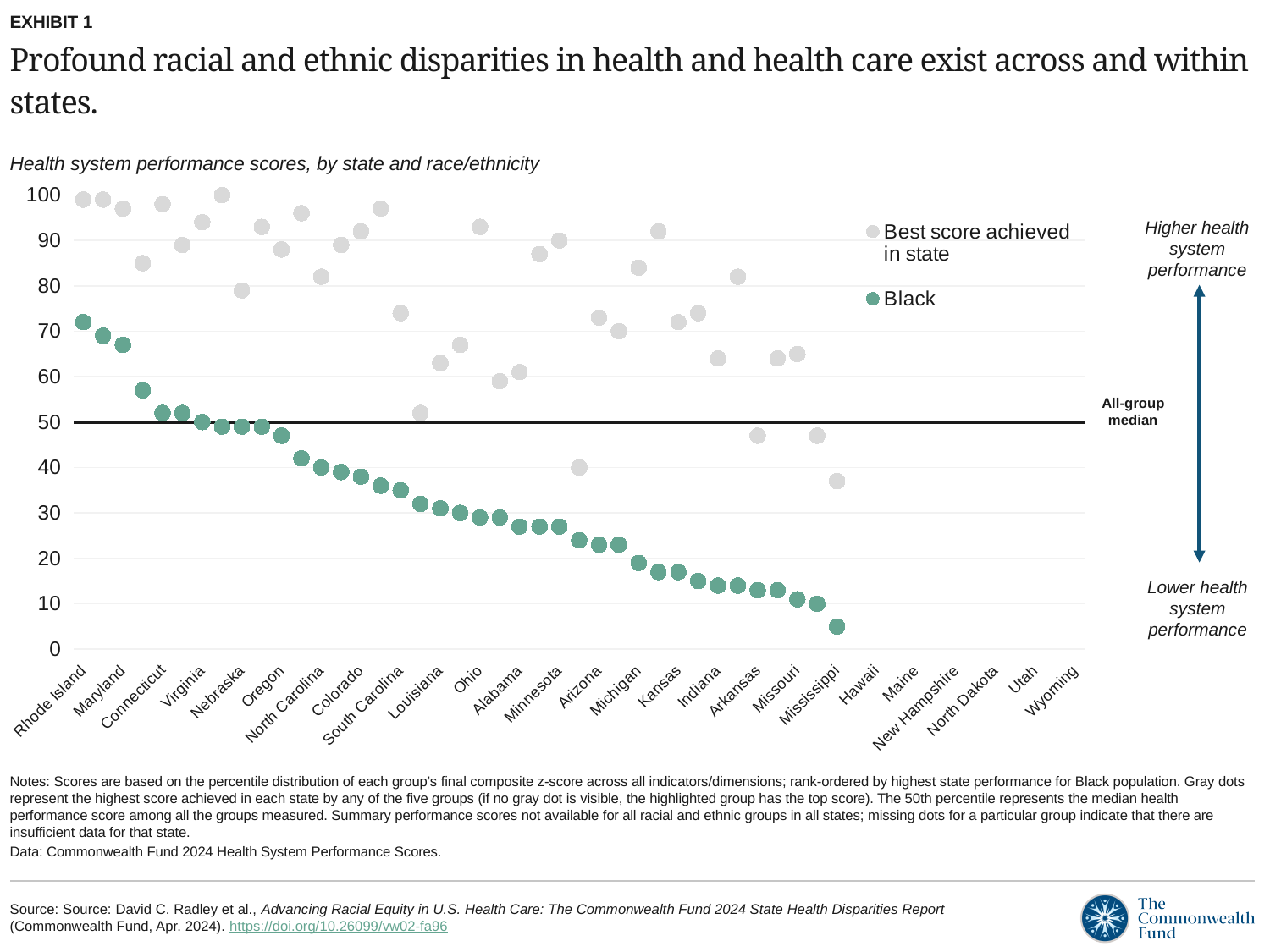
Is the best score achieved in Rhode Island greater or less than 90? greater Which labeled state has the highest health system performance score for the Black population? Rhode Island What are the two series named in the legend? Best score achieved in state; Black Which state has the larger Black population score, Rhode Island or Mississippi? Rhode Island Is the Black population score for Rhode Island greater or less than 60? greater Is the Black population score for Louisiana greater or less than 50? less Do the Black population scores rise or fall moving from left to right along the x axis? Fall What value does the horizontal 'All-group median' line sit at? 50 Which is larger for Rhode Island: the best score achieved in state or the Black population score? Best score achieved in state What kind of chart is shown on the slide? Scatter (dot) chart How many series does the legend list? 2